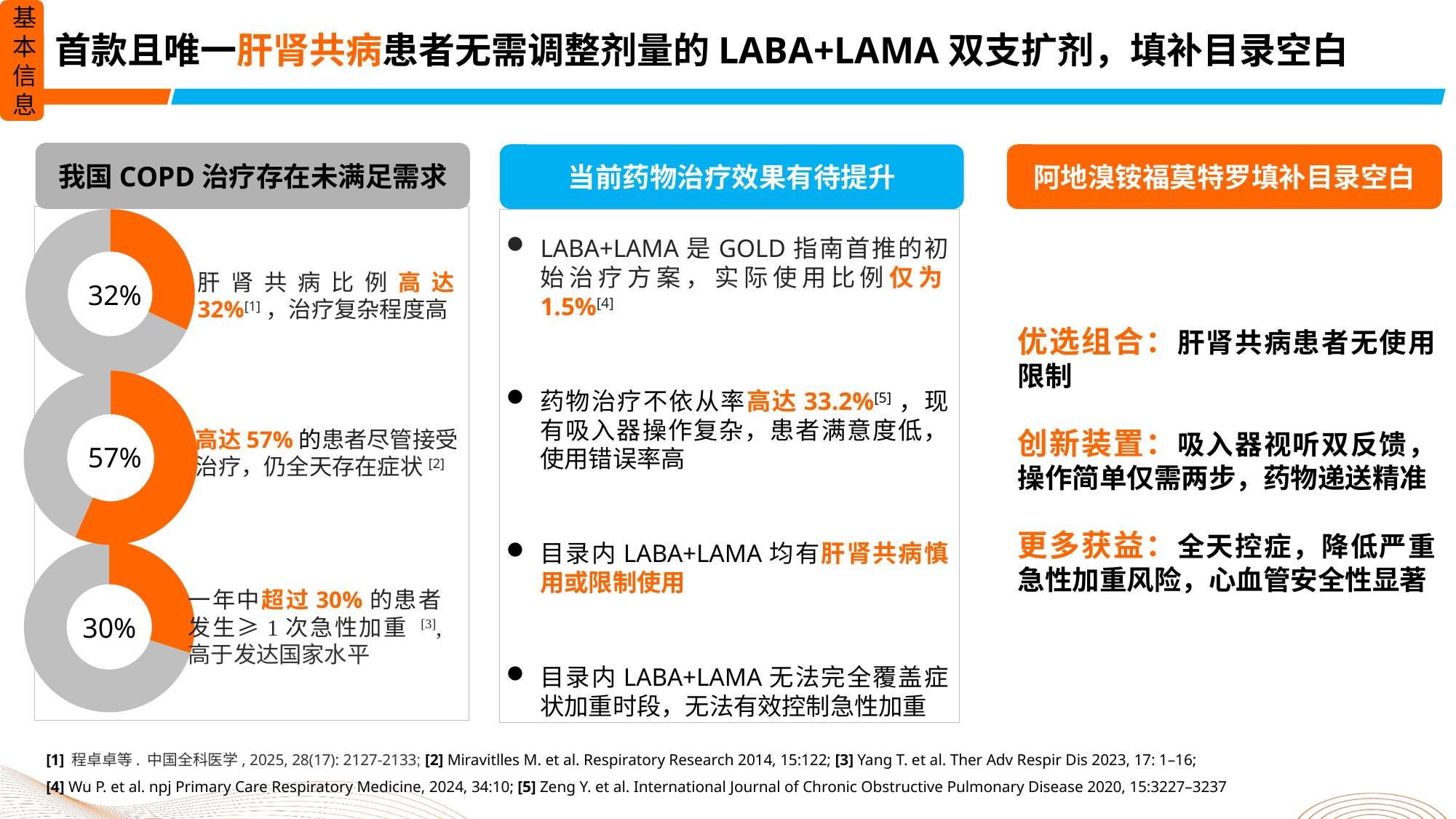
How many doughnut charts are shown in the left panel? 3 In the top doughnut chart, is the orange slice greater or less than half of the ring? less Which is larger, the percentage in the top doughnut chart or the percentage in the bottom doughnut chart? The top doughnut chart (32%) Which of the three doughnut charts in the left panel shows the lowest percentage? The bottom one (30%) What is the difference between the percentage in the middle doughnut chart and the percentage in the top doughnut chart? 25% What value is shown in the centre of the top doughnut chart in the left panel? 32% What value is shown in the centre of the middle doughnut chart in the left panel? 57% What kind of chart is used in the left panel to show the percentages? Doughnut chart Which of the three doughnut charts in the left panel shows the highest percentage? The middle one (57%) What colour is used for the highlighted slice in each doughnut chart in the left panel? Orange What value is shown in the centre of the bottom doughnut chart in the left panel? 30% In the middle doughnut chart, is the orange slice greater or less than half of the ring? greater